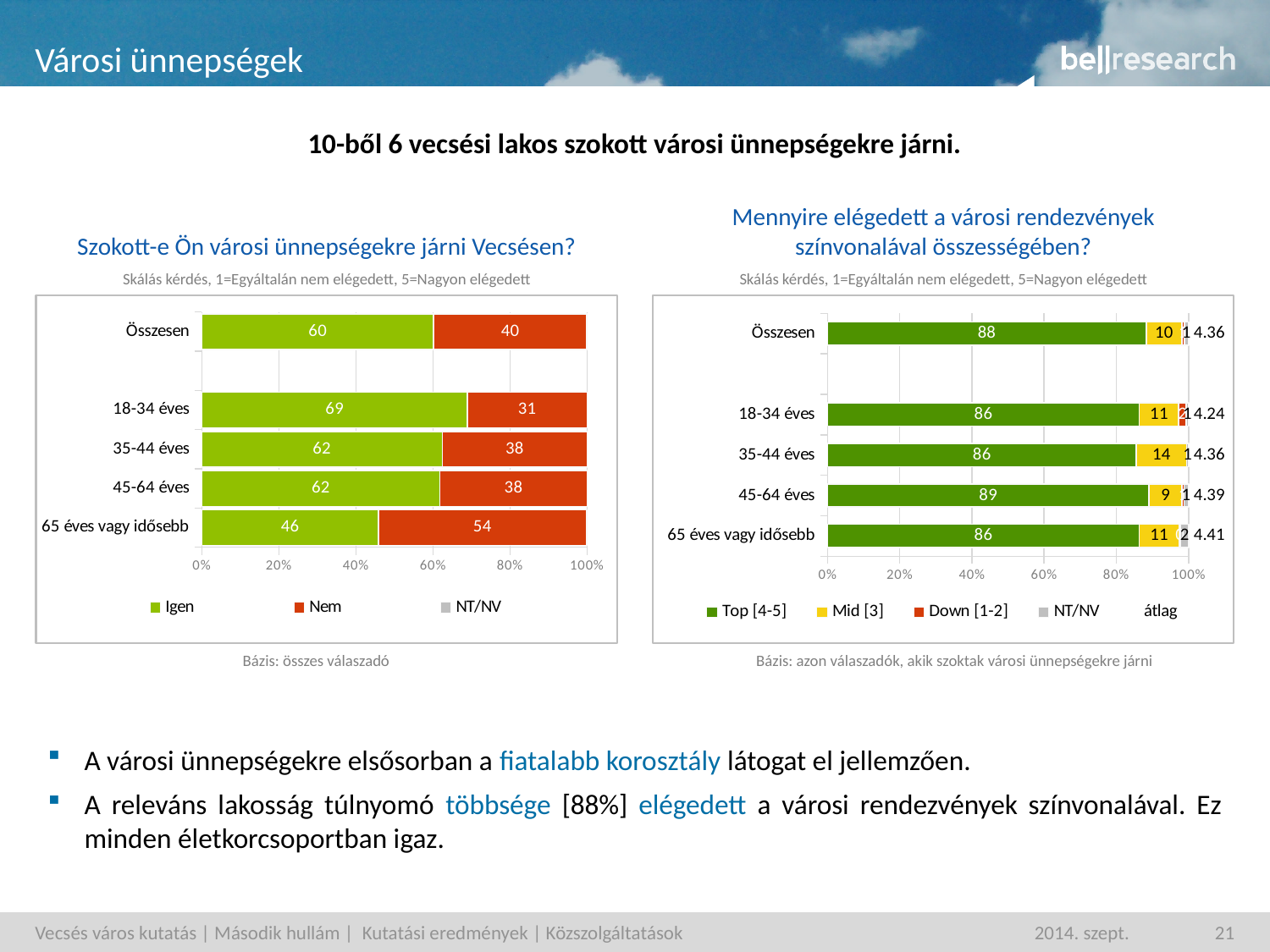
In the left chart 'Szokott-e Ön városi ünnepségekre járni Vecsésen?', what is the Igen value for 18-34 éves? 69 In the right chart 'Mennyire elégedett a városi rendezvények színvonalával összességében?', is the átlag for 18-34 éves larger or smaller than the átlag for 45-64 éves? smaller In the right chart 'Mennyire elégedett a városi rendezvények színvonalával összességében?', how many age categories are shown on the y axis? 4 In the right chart 'Mennyire elégedett a városi rendezvények színvonalával összességében?', what is the átlag value for 65 éves vagy idősebb? 4.41 In the right chart 'Mennyire elégedett a városi rendezvények színvonalával összességében?', which age group has the highest Mid [3] value? 35-44 éves In the left chart 'Szokott-e Ön városi ünnepségekre járni Vecsésen?', what is the difference between the Igen values for 18-34 éves and 65 éves vagy idősebb? 23 In the right chart 'Mennyire elégedett a városi rendezvények színvonalával összességében?', which age group has the highest Top [4-5] value? 45-64 éves In the left chart 'Szokott-e Ön városi ünnepségekre járni Vecsésen?', how many series does the legend list? 3 In the left chart 'Szokott-e Ön városi ünnepségekre járni Vecsésen?', which age group has the lowest Igen value? 65 éves vagy idősebb In the right chart 'Mennyire elégedett a városi rendezvények színvonalával összességében?', what is the Top [4-5] value for Összesen? 88 In the left chart 'Szokott-e Ön városi ünnepségekre járni Vecsésen?', what kind of chart is it? Stacked bar chart In the left chart 'Szokott-e Ön városi ünnepségekre járni Vecsésen?', what is the Nem value for 65 éves vagy idősebb? 54